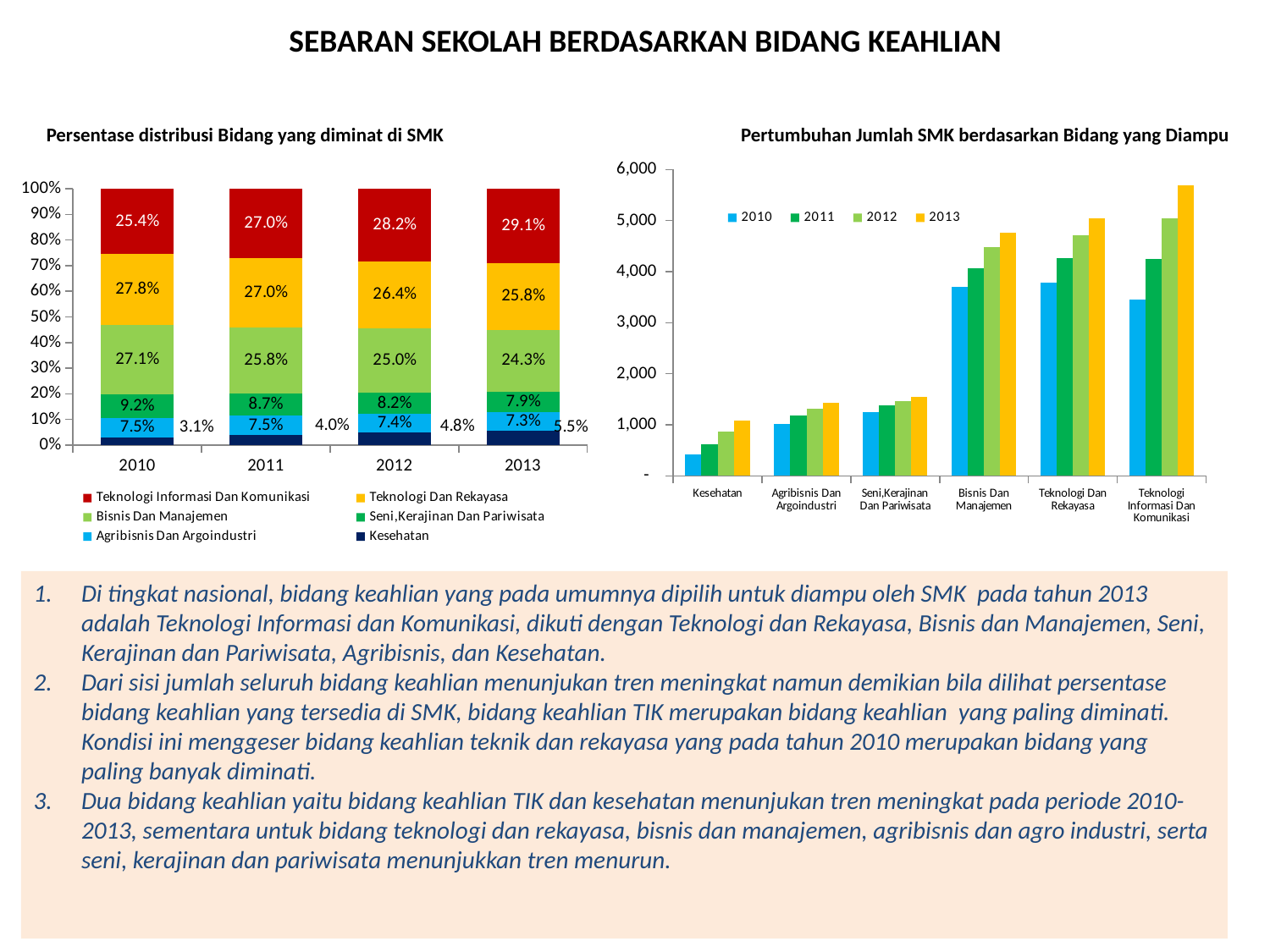
How many series does the legend of the chart 'Persentase distribusi Bidang yang diminat di SMK' list? 6 In the chart 'Persentase distribusi Bidang yang diminat di SMK', what is the value for Kesehatan in 2012? 4.8% In the chart 'Persentase distribusi Bidang yang diminat di SMK', which year has the highest value for Teknologi Informasi Dan Komunikasi? 2013 In the chart 'Persentase distribusi Bidang yang diminat di SMK', what is the value for Teknologi Informasi Dan Komunikasi in 2013? 29.1% In the chart 'Pertumbuhan Jumlah SMK berdasarkan Bidang yang Diampu', how many categories are shown on the x axis? 6 What kind of chart is 'Pertumbuhan Jumlah SMK berdasarkan Bidang yang Diampu'? bar chart In the chart 'Persentase distribusi Bidang yang diminat di SMK', what is the difference between the Teknologi Dan Rekayasa values in 2010 and 2013? 2.0% In the chart 'Pertumbuhan Jumlah SMK berdasarkan Bidang yang Diampu', which category has the lowest value in 2010? Kesehatan In the chart 'Pertumbuhan Jumlah SMK berdasarkan Bidang yang Diampu', is the value for Teknologi Informasi Dan Komunikasi in 2013 greater or less than 5,000? greater In the chart 'Persentase distribusi Bidang yang diminat di SMK', which is larger in 2011: Teknologi Informasi Dan Komunikasi or Bisnis Dan Manajemen? Teknologi Informasi Dan Komunikasi In the chart 'Persentase distribusi Bidang yang diminat di SMK', what is the value for Bisnis Dan Manajemen in 2010? 27.1% In the chart 'Persentase distribusi Bidang yang diminat di SMK', does the value for Seni,Kerajinan Dan Pariwisata rise or fall from 2010 to 2013? fall